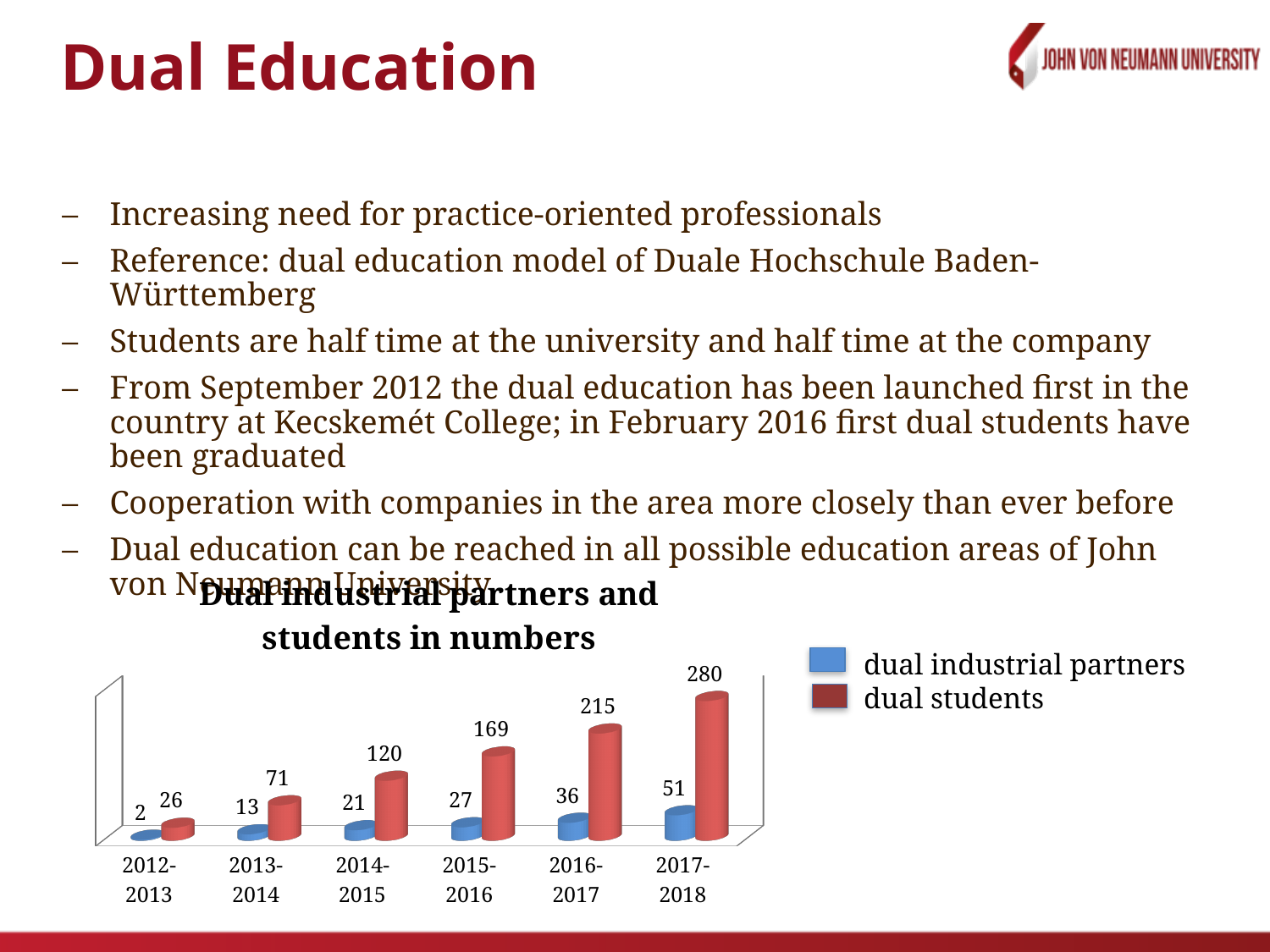
Do the numbers of dual students rise or fall from 2012-2013 to 2017-2018? rise What is the difference between the number of dual industrial partners in 2017-2018 and 2012-2013? 49 How many series does the chart legend list? 2 Which academic year had the highest number of dual students? 2017-2018 How many dual industrial partners were there in 2014-2015? 21 What kind of chart is shown on the slide? bar chart What is the difference between the number of dual students in 2016-2017 and 2015-2016? 46 How many academic years are shown on the x axis of the chart? 6 Which academic year had the lowest number of dual industrial partners? 2012-2013 Which is larger: the number of dual students in 2013-2014 or the number of dual industrial partners in 2017-2018? dual students in 2013-2014 How many dual students were there in 2017-2018? 280 What was the number of dual students in 2012-2013? 26